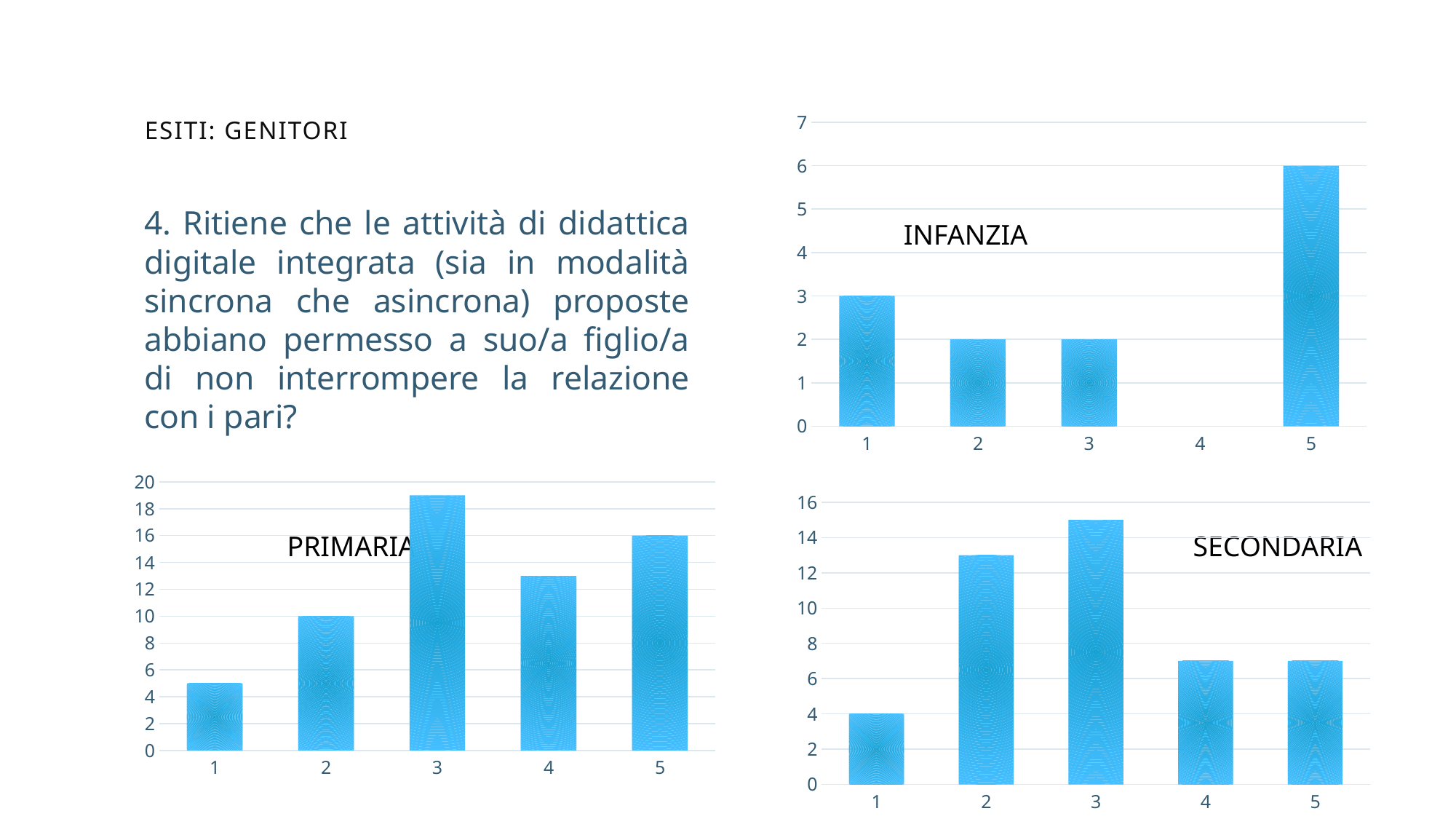
In the SECONDARIA chart, is the value for category 2 greater or less than 12? greater In the SECONDARIA chart, which category has the highest value? 3 In the INFANZIA chart, which category has the highest value? 5 In the INFANZIA chart, what is the value for category 1? 3 In the PRIMARIA chart, which category has the highest value? 3 In the PRIMARIA chart, is the value for category 3 greater or less than 18? greater In the SECONDARIA chart, what is the value for category 1? 4 In the INFANZIA chart, what is the value for category 5? 6 What kind of chart is the PRIMARIA chart? bar chart In the PRIMARIA chart, what is the value for category 2? 10 In the PRIMARIA chart, which category has the lowest value? 1 In the INFANZIA chart, what is the difference between the values for category 5 and category 1? 3